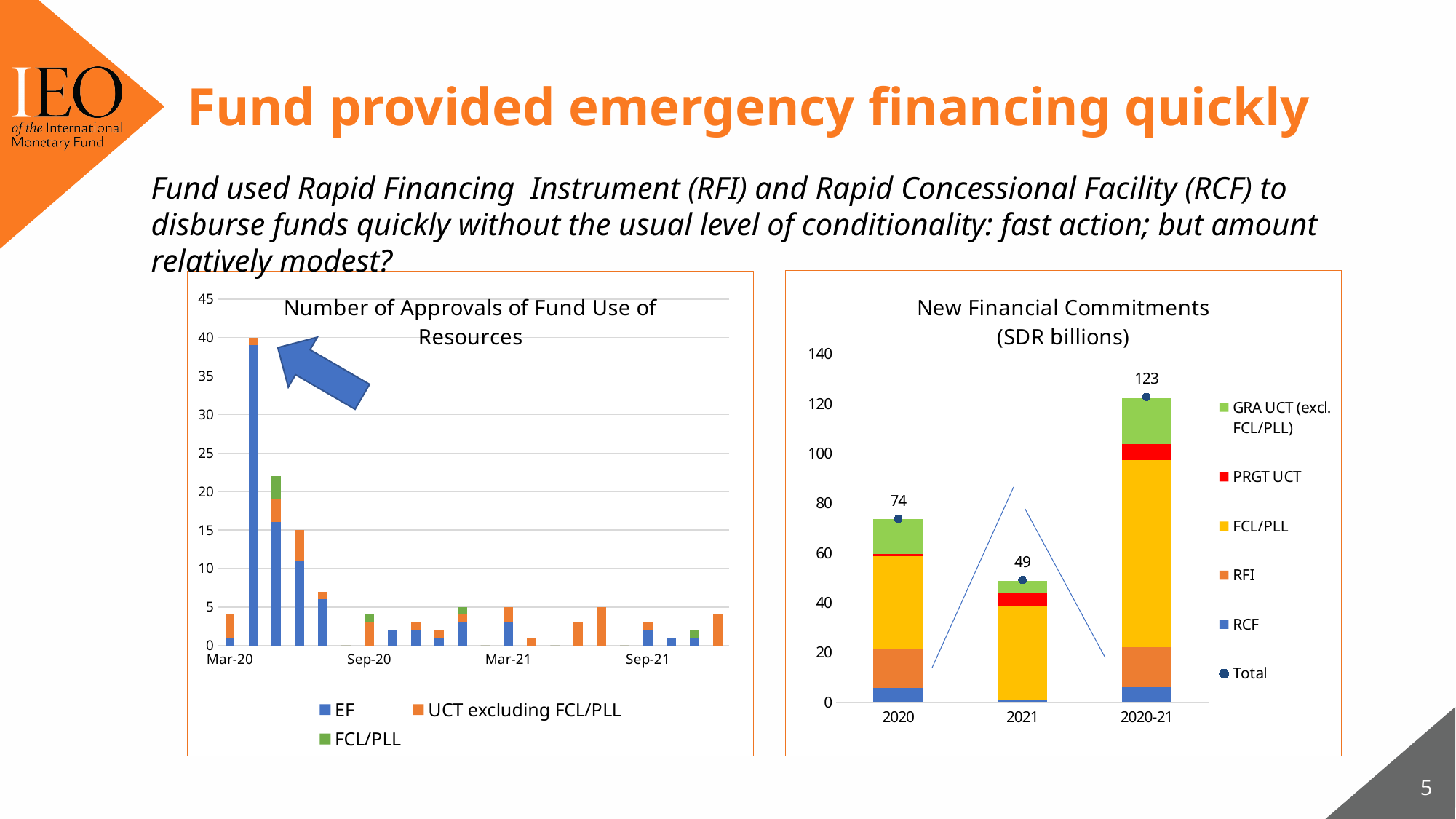
In the New Financial Commitments chart, what is the total for 2021? 49 In the New Financial Commitments chart, is the total for 2021 greater or less than 60? less How many entries does the legend of the New Financial Commitments chart list? 6 In the New Financial Commitments chart, what is the total for 2020? 74 In the New Financial Commitments chart, which category has the lowest total? 2021 In the New Financial Commitments chart, which total is larger, 2020 or 2021? 2020 In the New Financial Commitments chart, which category has the highest total? 2020-21 What kind of chart is the Number of Approvals of Fund Use of Resources chart on the left? Bar chart In the New Financial Commitments chart, what is the total for 2020-21? 123 How many categories are shown on the x axis of the New Financial Commitments chart? 3 How many series does the legend of the Number of Approvals of Fund Use of Resources chart list? 3 In the New Financial Commitments chart, what is the difference between the 2020 total and the 2021 total? 25